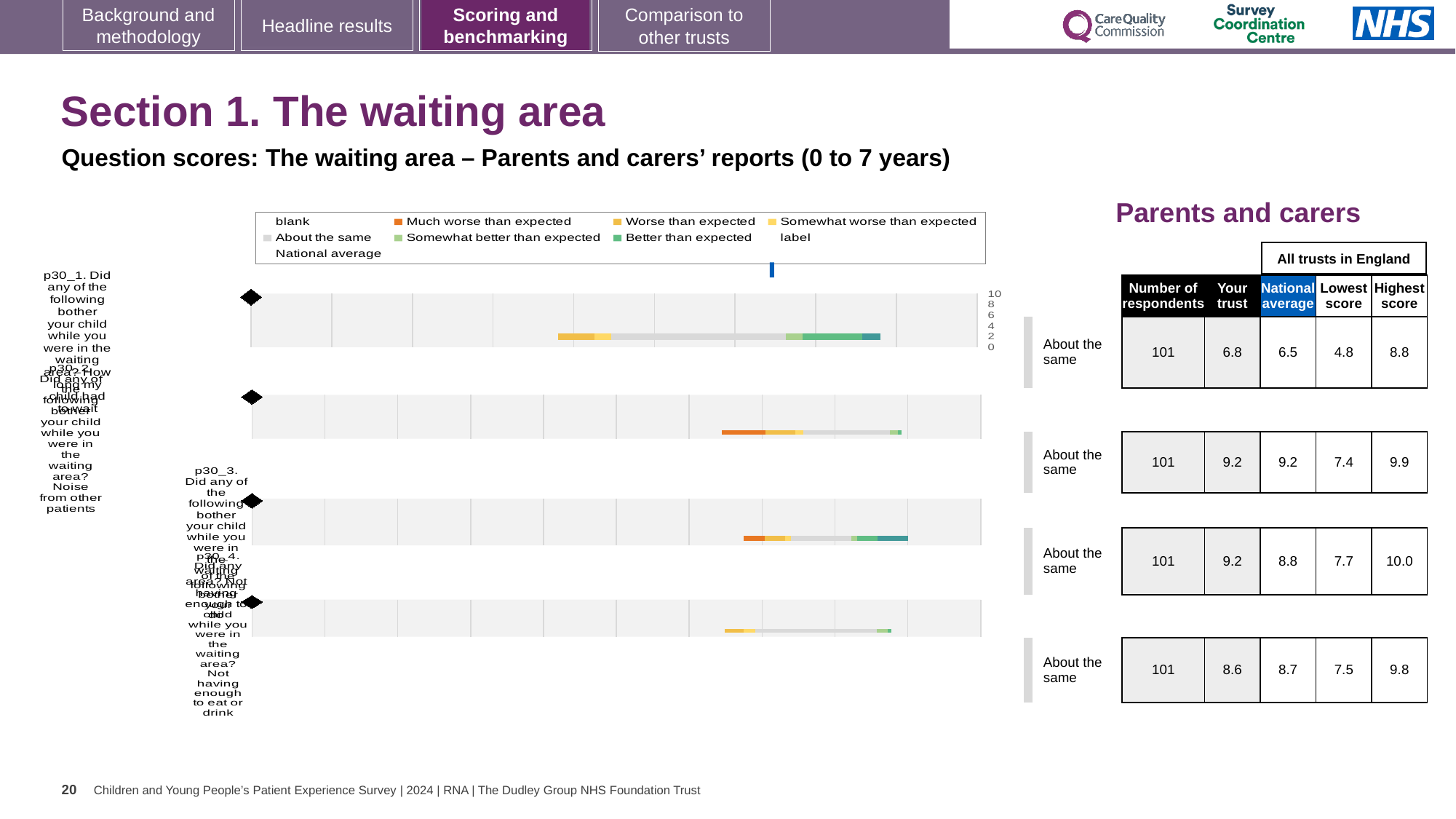
In the table beside the chart, what is the number of respondents for each question? 101 How many entries does the chart legend list? 9 In the table beside the chart, what is the 'Your trust' score for the first question (p30_1)? 6.8 In the table beside the chart, is the 'Your trust' score for the fourth question (p30_4) larger or smaller than its national average? smaller What colour does the legend use for 'Much worse than expected'? orange What kind of chart is shown on the slide? bar chart In the table beside the chart, which question has the highest 'Highest score' value? p30_3 What is the highest value shown on the chart's axis? 10 In the table beside the chart, what is the difference between the 'Your trust' score and the national average for the first question (p30_1)? 0.3 How many bars (question categories) are plotted in the chart? 4 In the table beside the chart, what is the national average for the third question (p30_3)? 8.8